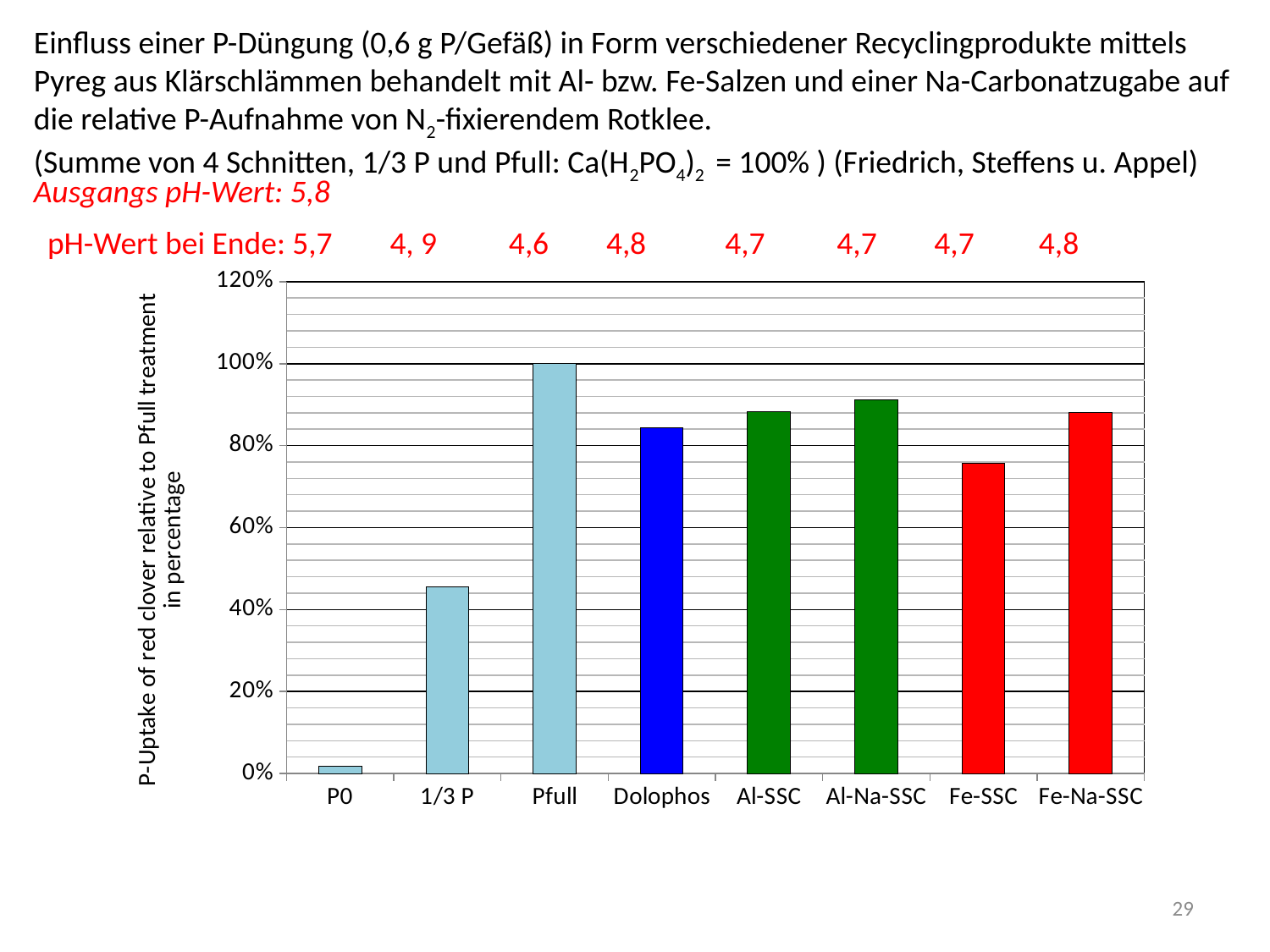
Which category has the lowest P-uptake value in the chart? P0 What colour are the bars for Fe-SSC and Fe-Na-SSC? red Is the value for 1/3 P greater or less than 60%? less How many categories are plotted on the x axis of the chart? 8 Is the value for Fe-SSC greater or less than 80%? less What kind of chart is shown on the slide? bar chart What is the P-uptake value for Pfull? 100% Which has the larger P-uptake value, Al-Na-SSC or Fe-SSC? Al-Na-SSC Which has the larger P-uptake value, Dolophos or 1/3 P? Dolophos Which category has the highest P-uptake value in the chart? Pfull Is the value for P0 greater or less than 20%? less